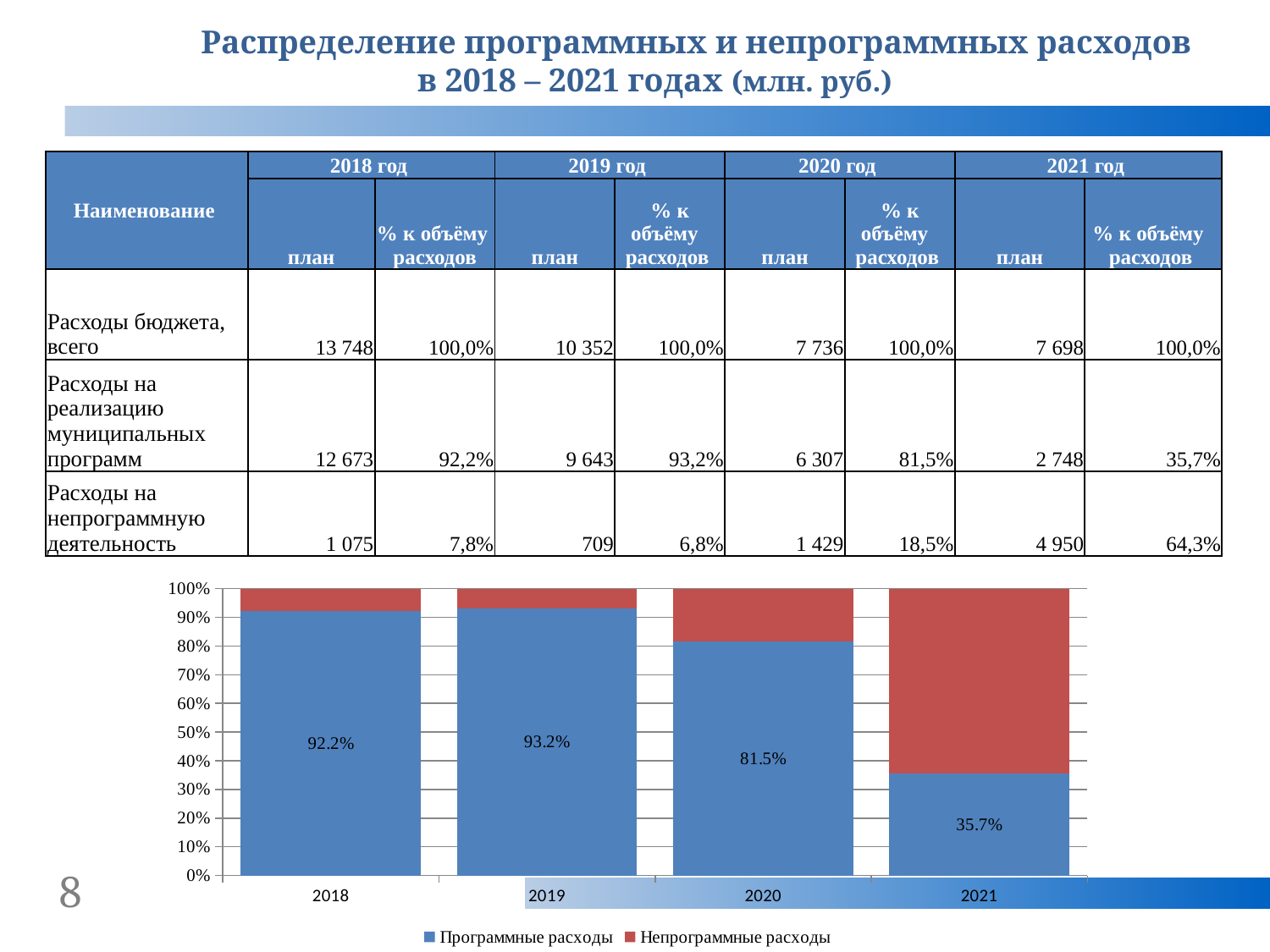
Is the share of Непрограммные расходы in 2021 greater or less than 60%? greater What is the value for Программные расходы in 2021? 35.7% What is the value for Программные расходы in 2018? 92.2% Which year has a larger share of Программные расходы, 2018 or 2020? 2018 Which year has the highest share of Программные расходы? 2019 What type of chart is shown on the slide? Stacked bar chart What is the difference between the Программные расходы share in 2019 and in 2021? 57.5% What is the value for Программные расходы in 2020? 81.5% Which year has the lowest share of Программные расходы? 2021 How many years are shown on the x axis of the chart? 4 How many series does the chart legend list? 2 Is the share of Непрограммные расходы in 2020 greater or less than 10%? greater